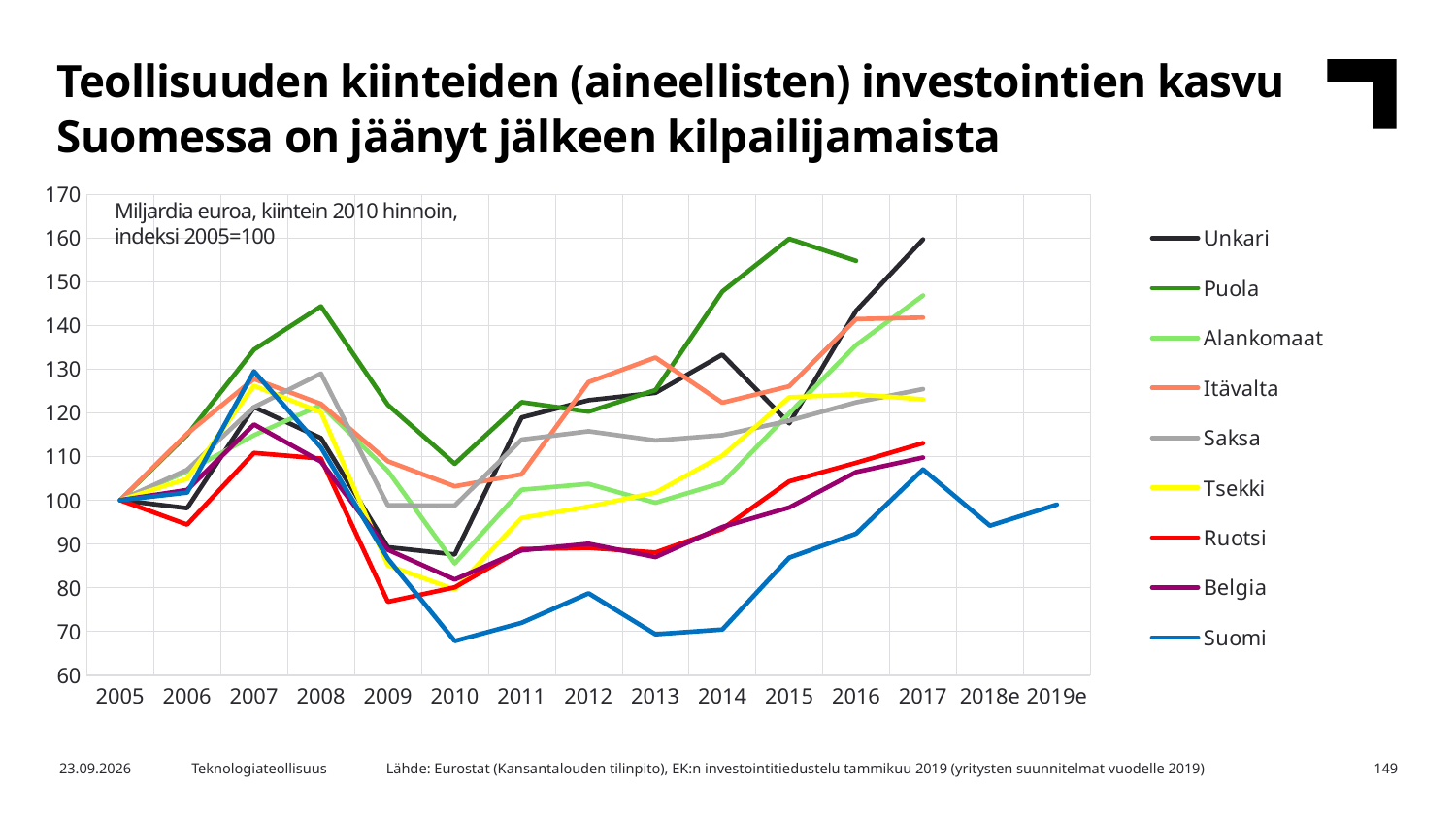
Is the value for Suomi in 2019e greater or less than 90? greater In 2017, which is larger, the value for Unkari or the value for Suomi? Unkari How many series does the legend list? 9 Does the value for Suomi rise or fall from 2017 to 2018e? fall Which country is the last entry in the legend? Suomi Is the value for Puola in 2015 greater or less than 150? greater What kind of chart is shown on the slide? line chart Which country has the lowest value in 2013? Suomi How many years are shown on the x axis? 15 Is the value for Suomi in 2010 greater or less than 80? less Which country has the highest value in 2015? Puola What is the index value for Suomi in 2005? 100